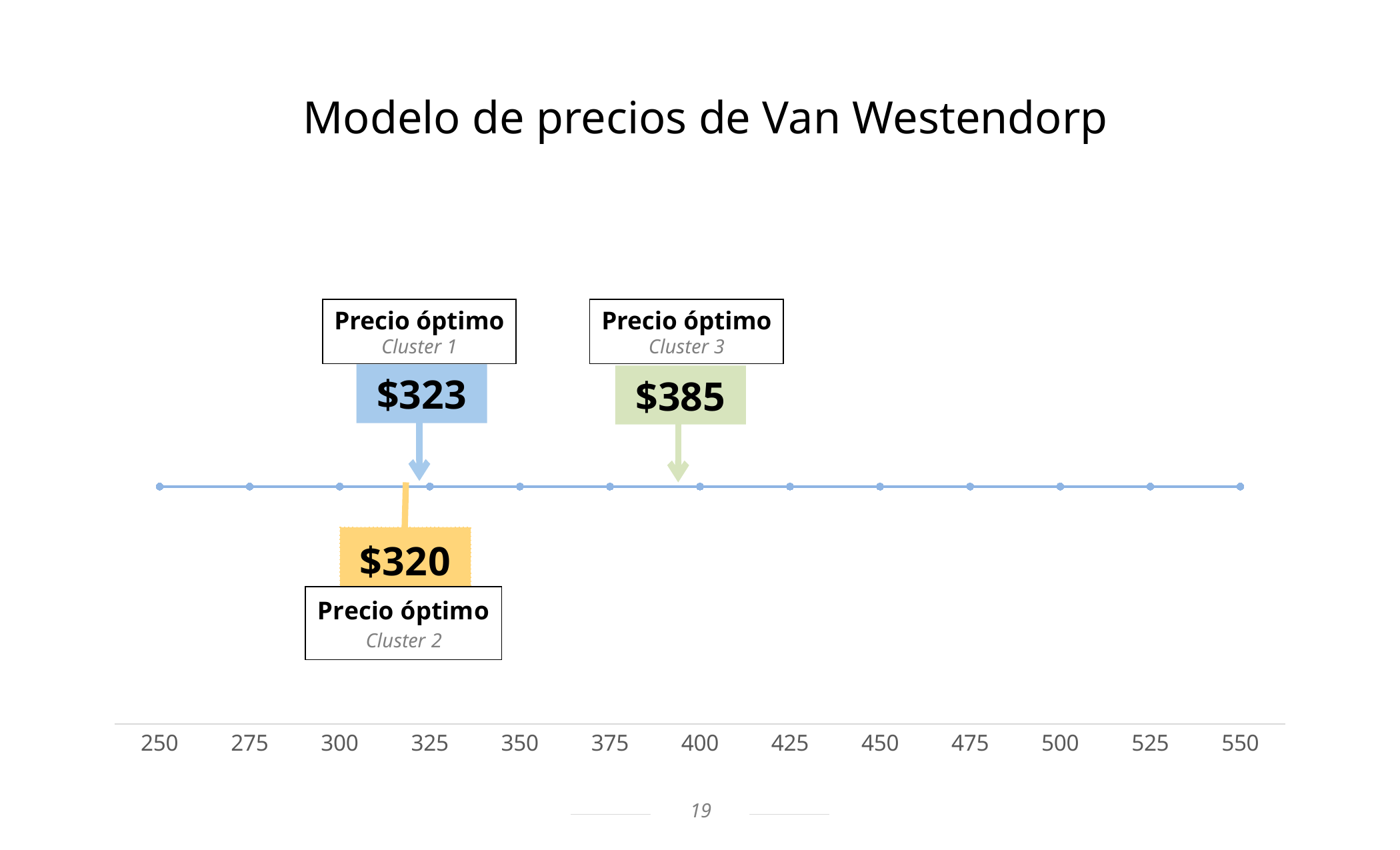
Which is larger, the optimal price for Cluster 1 or for Cluster 3? Cluster 3 What is the difference between the optimal price of Cluster 3 and the optimal price of Cluster 1? $62 Which cluster has the highest optimal price? Cluster 3 Which cluster has the lowest optimal price? Cluster 2 What is the title of the slide? Modelo de precios de Van Westendorp What are the lowest and highest values shown on the price axis? 250 and 550 What is the difference between the optimal price of Cluster 1 and the optimal price of Cluster 2? $3 What is the optimal price (Precio óptimo) for Cluster 2? $320 Is the optimal price for Cluster 3 greater or less than 400? less What is the optimal price (Precio óptimo) for Cluster 3? $385 What is the optimal price (Precio óptimo) for Cluster 1? $323 How many clusters have an optimal price marked on the price line? 3